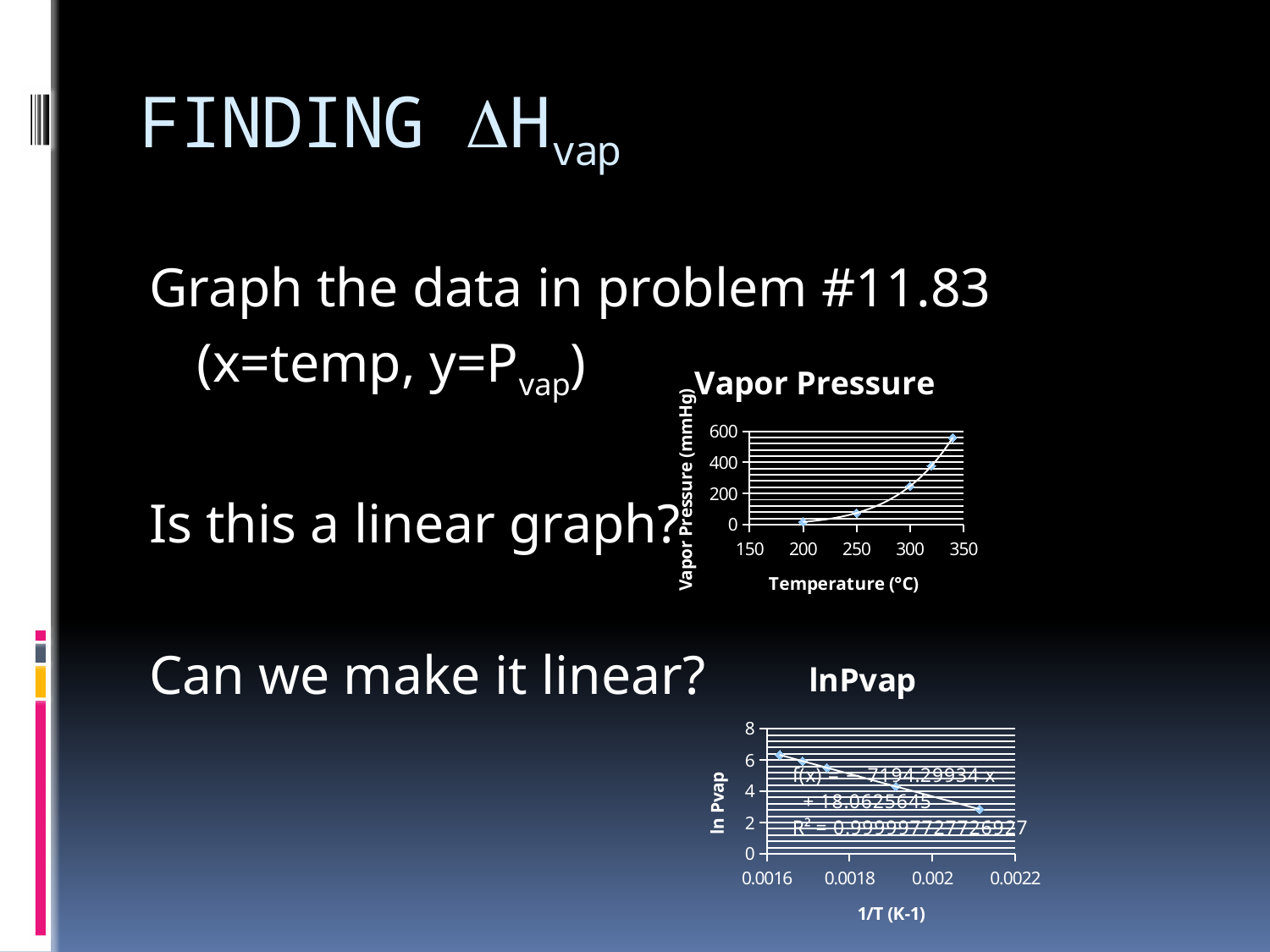
What kind of chart is the 'Vapor Pressure' chart? scatter chart In the 'lnPvap' chart, which is larger: the ln Pvap value at the leftmost point or at the rightmost point? the leftmost point In the 'Vapor Pressure' chart, is the vapor pressure at 250 °C greater or less than 200 mmHg? less How many data points are plotted in the 'Vapor Pressure' chart? 5 In the 'lnPvap' chart, is the ln Pvap value at the leftmost point (near 0.0016) greater or less than 4? greater In the 'lnPvap' chart, do the values rise or fall as 1/T increases? fall In the 'Vapor Pressure' chart, do the values rise or fall as temperature increases? rise What R² value is shown for the trendline in the 'lnPvap' chart? 0.999997727726927 In the 'Vapor Pressure' chart, is the vapor pressure at 200 °C greater or less than 200 mmHg? less What is the x-axis title of the 'Vapor Pressure' chart? Temperature (°C)